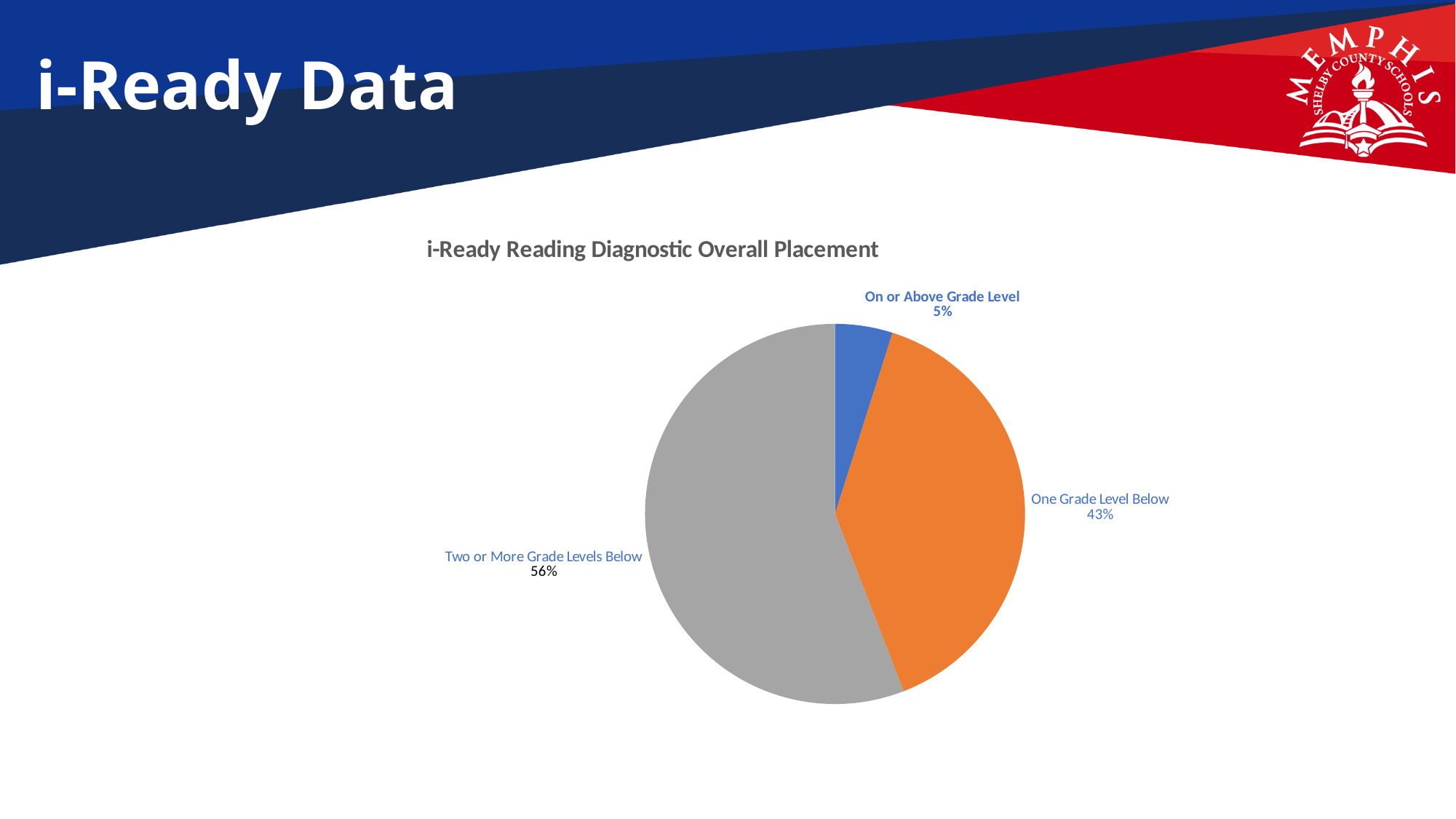
What colour is the slice for Two or More Grade Levels Below? grey What is the title of the chart? i-Ready Reading Diagnostic Overall Placement How many categories are shown in the pie chart? 3 What type of chart is shown on the slide? pie chart What percentage of students are Two or More Grade Levels Below? 56% What is the difference in percentage points between Two or More Grade Levels Below and One Grade Level Below? 13 Which placement category has the largest share of the pie? Two or More Grade Levels Below What is the combined percentage of students who are below grade level (One Grade Level Below plus Two or More Grade Levels Below)? 99% What percentage of students are On or Above Grade Level? 5% Which placement category has the smallest share of the pie? On or Above Grade Level What percentage of students are One Grade Level Below? 43% Which is larger: the share for One Grade Level Below or the share for On or Above Grade Level? One Grade Level Below